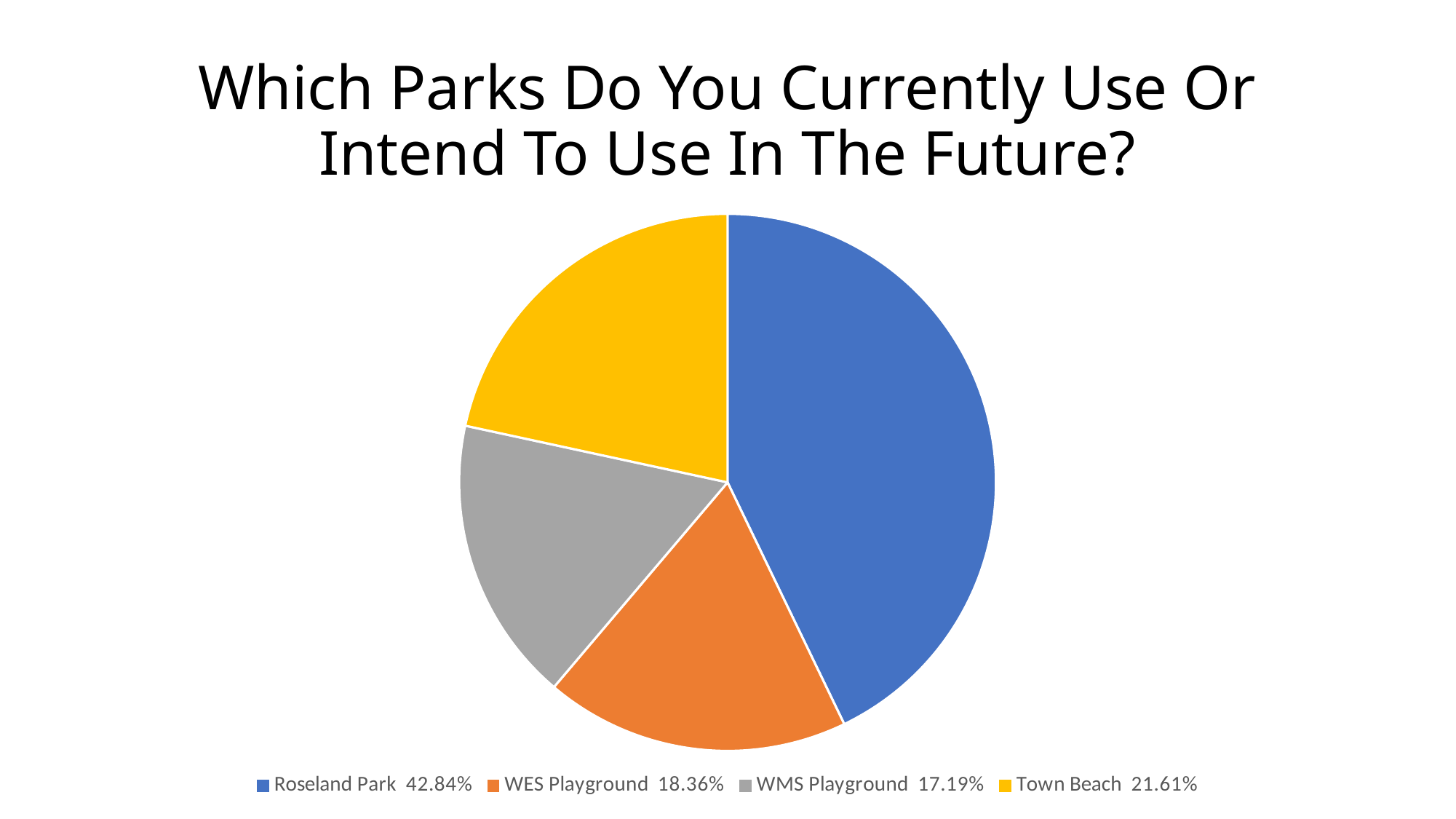
How many slices does the pie chart have? 4 What kind of chart is shown on the slide? pie chart What colour is the Town Beach slice? yellow What share of the pie does Town Beach have? 21.61% What is the difference in percentage points between WES Playground and WMS Playground? 1.17 Which park has the smallest share of the pie? WMS Playground Which park has the largest share of the pie? Roseland Park What share of the pie does WES Playground have? 18.36% What share of the pie does WMS Playground have? 17.19% Which has a larger share, Town Beach or WES Playground? Town Beach What is the difference in percentage points between Roseland Park and Town Beach? 21.23